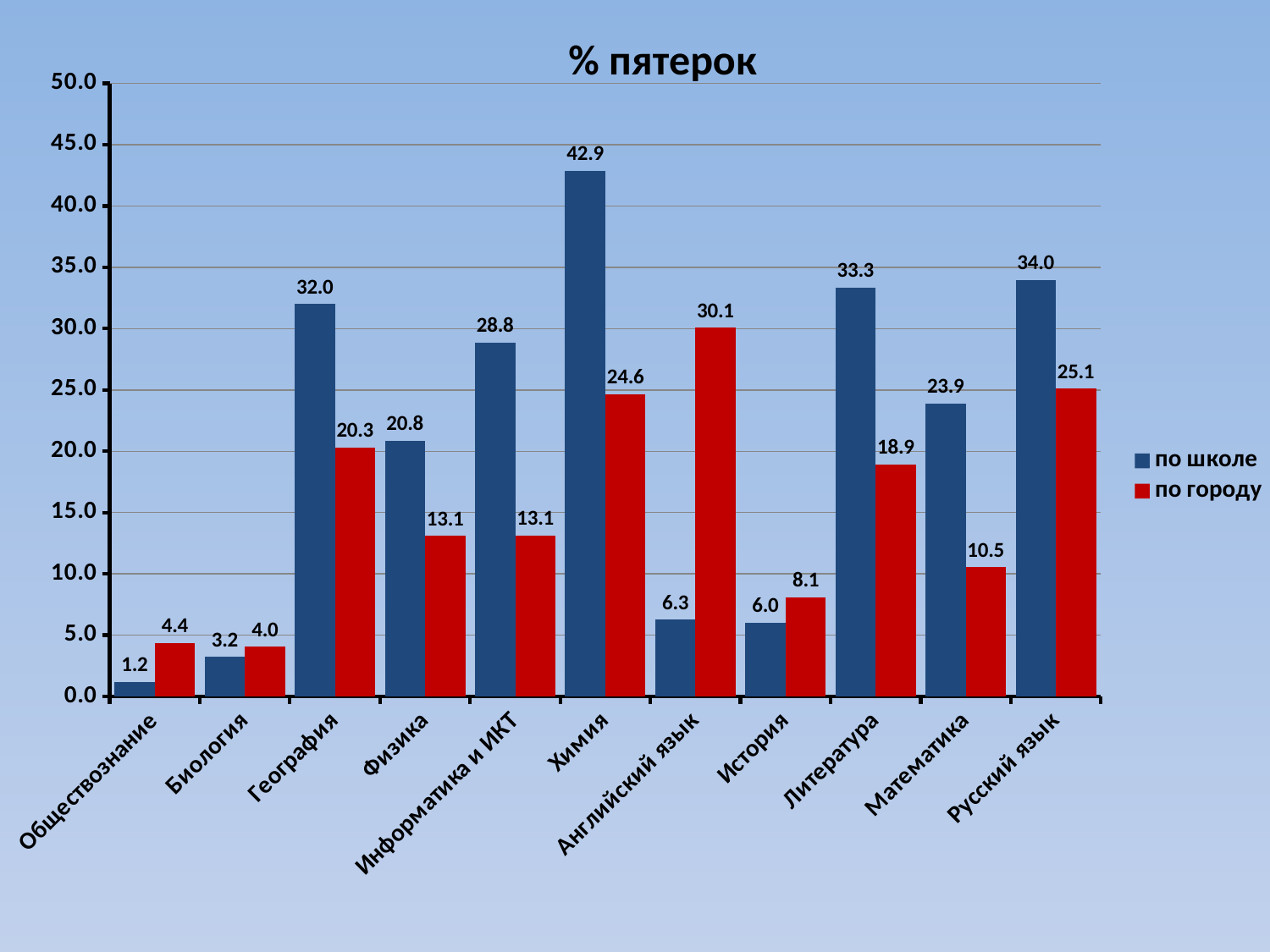
Which category has the lowest value in the по школе series? Обществознание What is the difference between the по школе and по городу values for Химия? 18.3 Which is larger for Английский язык: the по школе value or the по городу value? по городу What is the title of the chart? % пятерок Which category has the highest value in the по школе series? Химия What is the value for Химия in the по школе series? 42.9 Which category has the lowest value in the по городу series? Биология How many series does the legend list? 2 What is the value for Английский язык in the по городу series? 30.1 What kind of chart is shown on the slide? bar chart Is the по школе value for Русский язык greater or less than 30.0? greater How many categories are shown on the x axis? 11